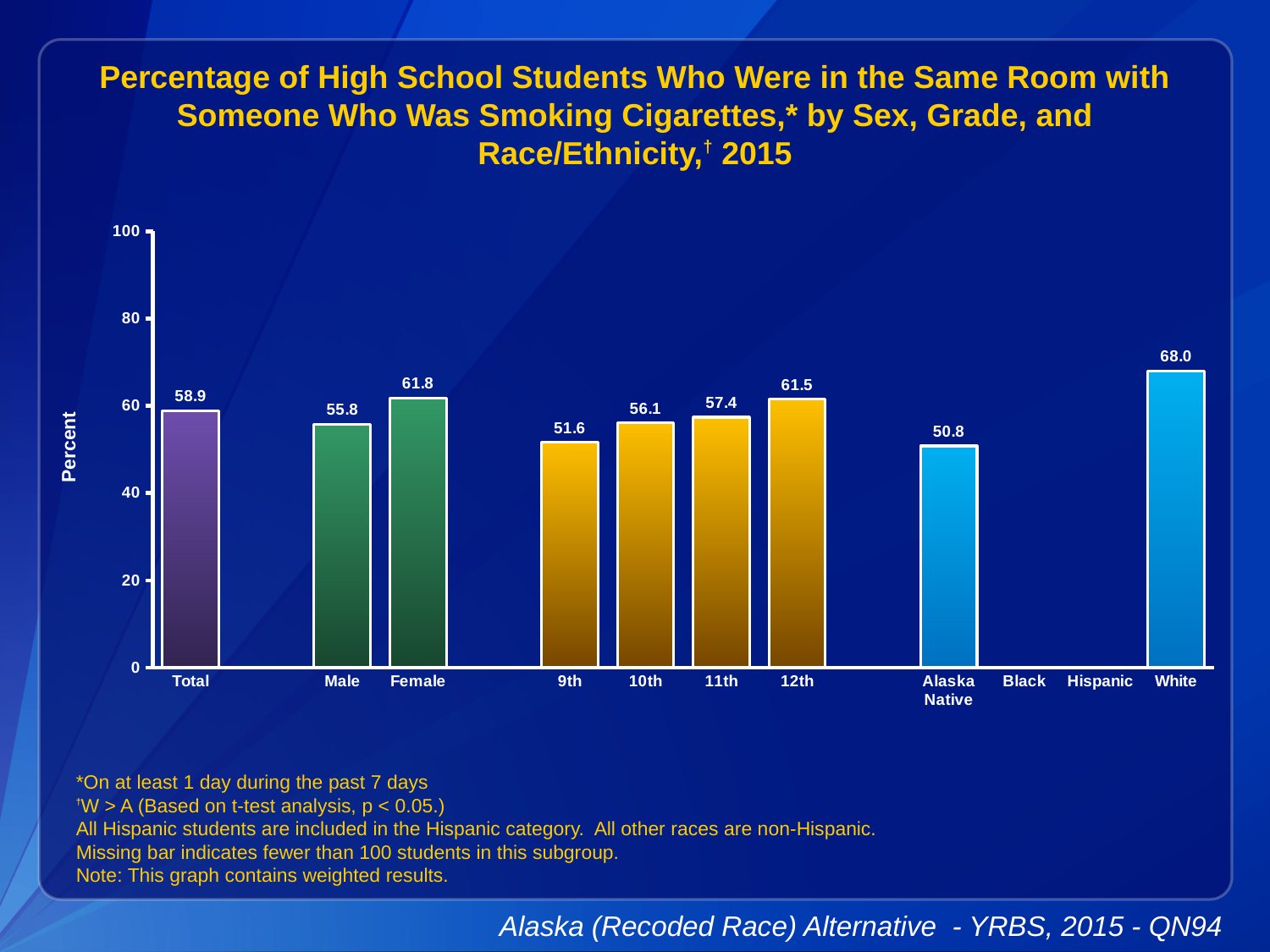
Is the value for White greater or less than 60? greater Which category with a bar has the lowest value? Alaska Native Which is larger, the value for 12th grade or the value for 9th grade? 12th Do the values rise or fall from 9th grade to 12th grade? rise What is the value for Female? 61.8 What is the difference between the Female and Male values? 6.0 Which categories on the x axis have no bar? Black and Hispanic What kind of chart is shown? bar chart What is the value for Total? 58.9 What is the value for Alaska Native? 50.8 Which category has the highest value? White How many bars are plotted on the chart? 9